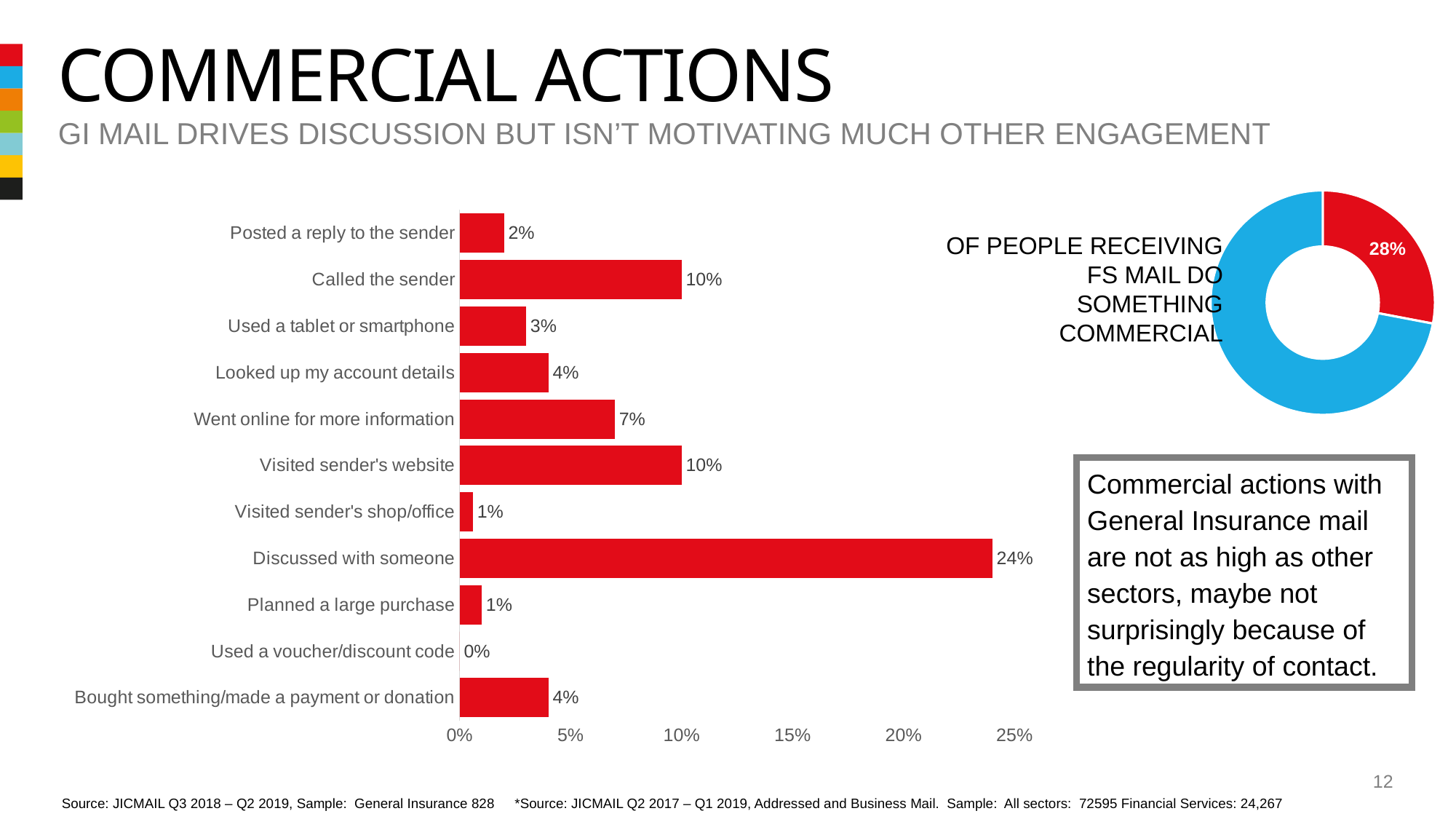
What kind of chart is the chart on the right of the slide? Donut chart In the bar chart on the left, what is the difference between "Discussed with someone" and "Visited sender's website"? 14% How many categories does the bar chart on the left show? 11 In the bar chart on the left, is the value for "Discussed with someone" greater or less than 20%? greater In the bar chart on the left, which category has the highest value? Discussed with someone What kind of chart is the chart on the left of the slide? Bar chart In the bar chart on the left, which category has the lowest value? Used a voucher/discount code In the bar chart on the left, what is the value for "Discussed with someone"? 24% In the bar chart on the left, what is the value for "Called the sender"? 10% In the bar chart on the left, what is the value for "Went online for more information"? 7% In the bar chart on the left, which is larger: "Looked up my account details" or "Used a tablet or smartphone"? Looked up my account details In the donut chart on the right, what percentage of people receiving FS mail do something commercial? 28%